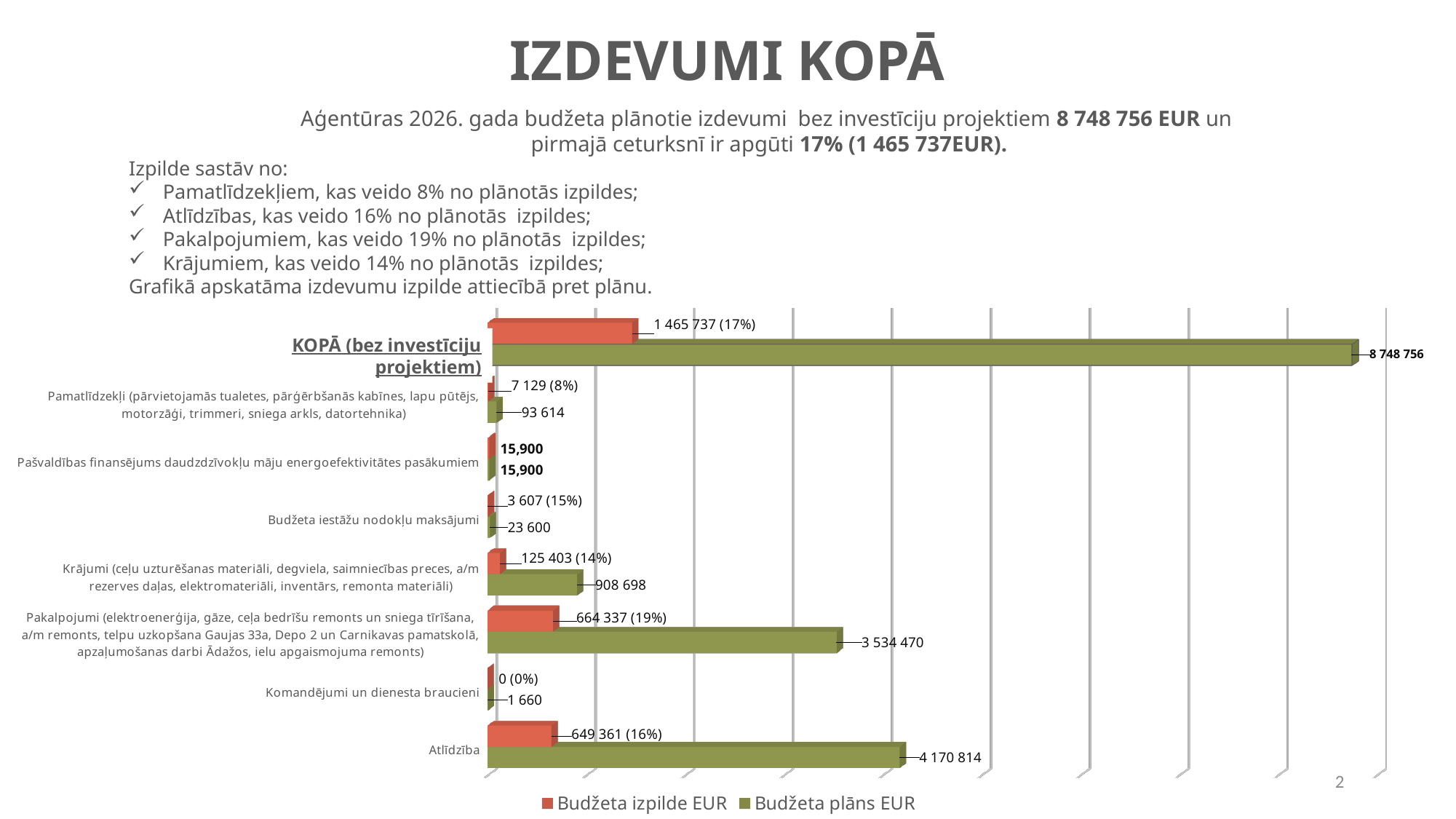
Which is larger, the Budžeta plāns EUR value for Atlīdzība or for Pakalpojumi? Atlīdzība What is the Budžeta plāns EUR value for Pakalpojumi? 3 534 470 What is the Budžeta plāns EUR value for KOPĀ (bez investīciju projektiem)? 8 748 756 Which series is shown in red on the chart? Budžeta izpilde EUR Which category has the highest Budžeta plāns EUR value? KOPĀ (bez investīciju projektiem) What is the difference between the Budžeta plāns EUR and Budžeta izpilde EUR values for Krājumi? 783 295 What is the Budžeta izpilde EUR value for Atlīdzība? 649 361 (16%) What is the Budžeta izpilde EUR value for Krājumi? 125 403 (14%) How many categories are plotted on the chart? 8 How many series does the chart legend list? 2 What kind of chart is shown on the slide? bar chart Which category has the lowest Budžeta plāns EUR value? Komandējumi un dienesta braucieni